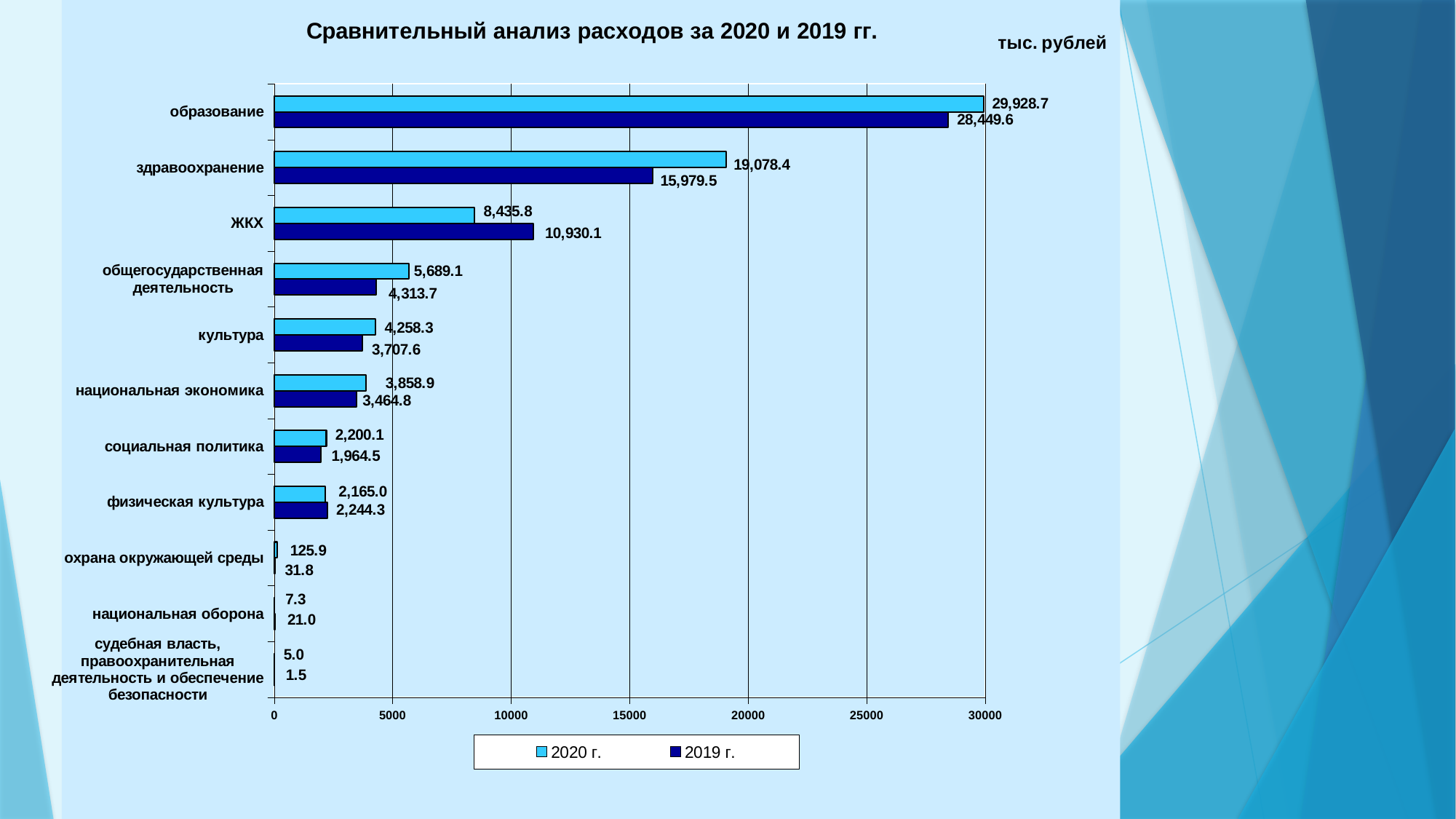
For физическая культура, which year has the larger value, 2020 г. or 2019 г.? 2019 г. What is the 2019 г. value for ЖКХ? 10,930.1 Which category has the highest 2020 г. value? образование Is the 2019 г. value for здравоохранение greater or less than 15000? greater What is the difference between the 2019 г. and 2020 г. values for ЖКХ? 2,494.3 How many series does the legend list? 2 What is the difference between the 2020 г. and 2019 г. values for образование? 1,479.1 How many categories are shown on the chart? 11 What is the 2020 г. value for здравоохранение? 19,078.4 Which category has the lowest 2019 г. value? судебная власть, правоохранительная деятельность и обеспечение безопасности What is the 2020 г. value for охрана окружающей среды? 125.9 What type of chart is shown on the slide? bar chart